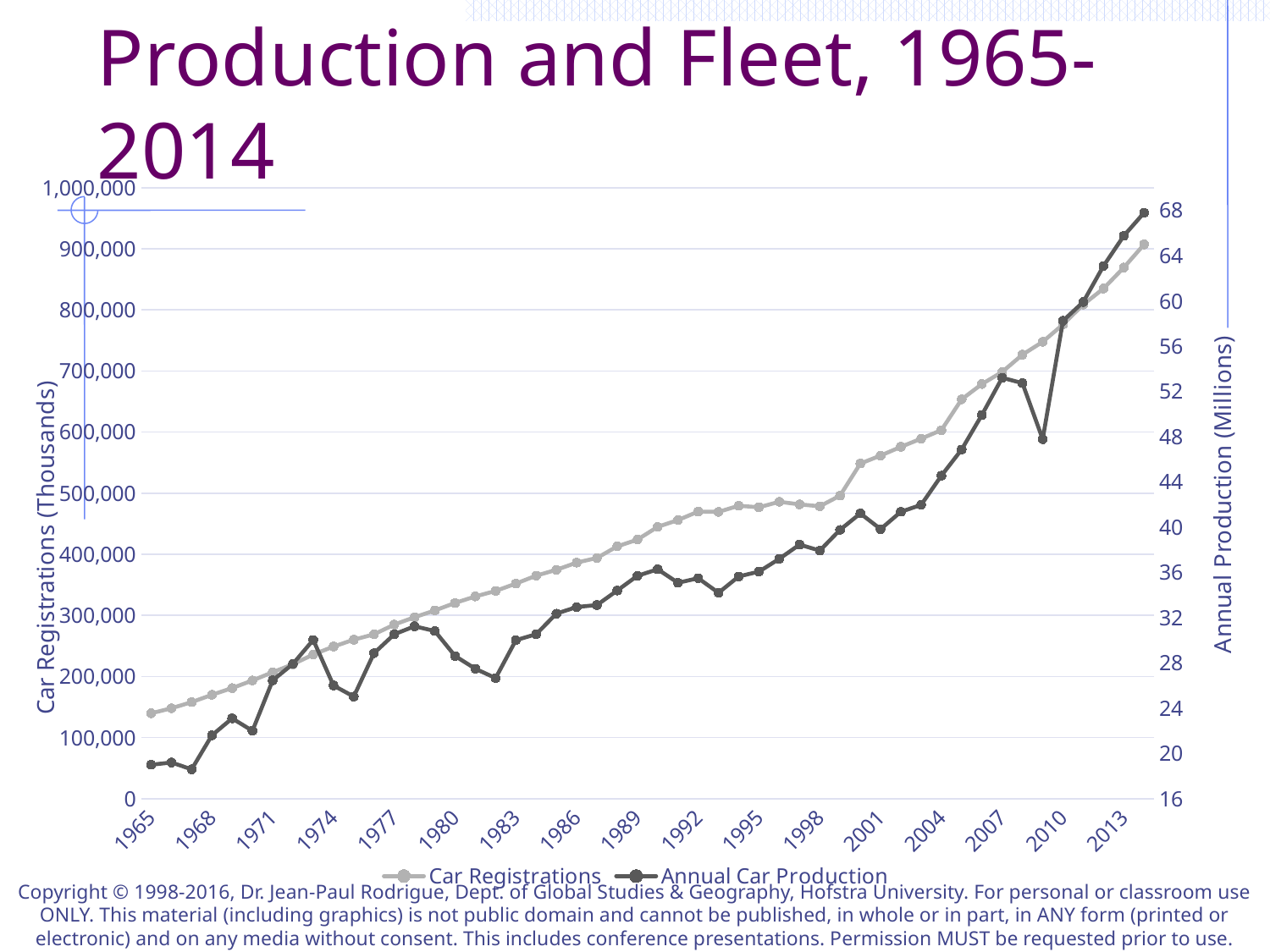
Is the value for Car Registrations in 2014 greater or less than 800,000? greater In which year are Car Registrations lowest? 1965 What are the two series named in the legend? Car Registrations and Annual Car Production Is the value for Annual Car Production in 2014 greater or less than 64? greater In which year is Annual Car Production highest? 2014 Is the value for Annual Car Production in 1965 greater or less than 20? less Do Car Registrations generally rise or fall from 1965 to 2014? Rise In which year are Car Registrations highest? 2014 What is the label of the right-hand vertical axis? Annual Production (Millions) How many series does the legend list? 2 What kind of chart is shown on the slide? Line chart